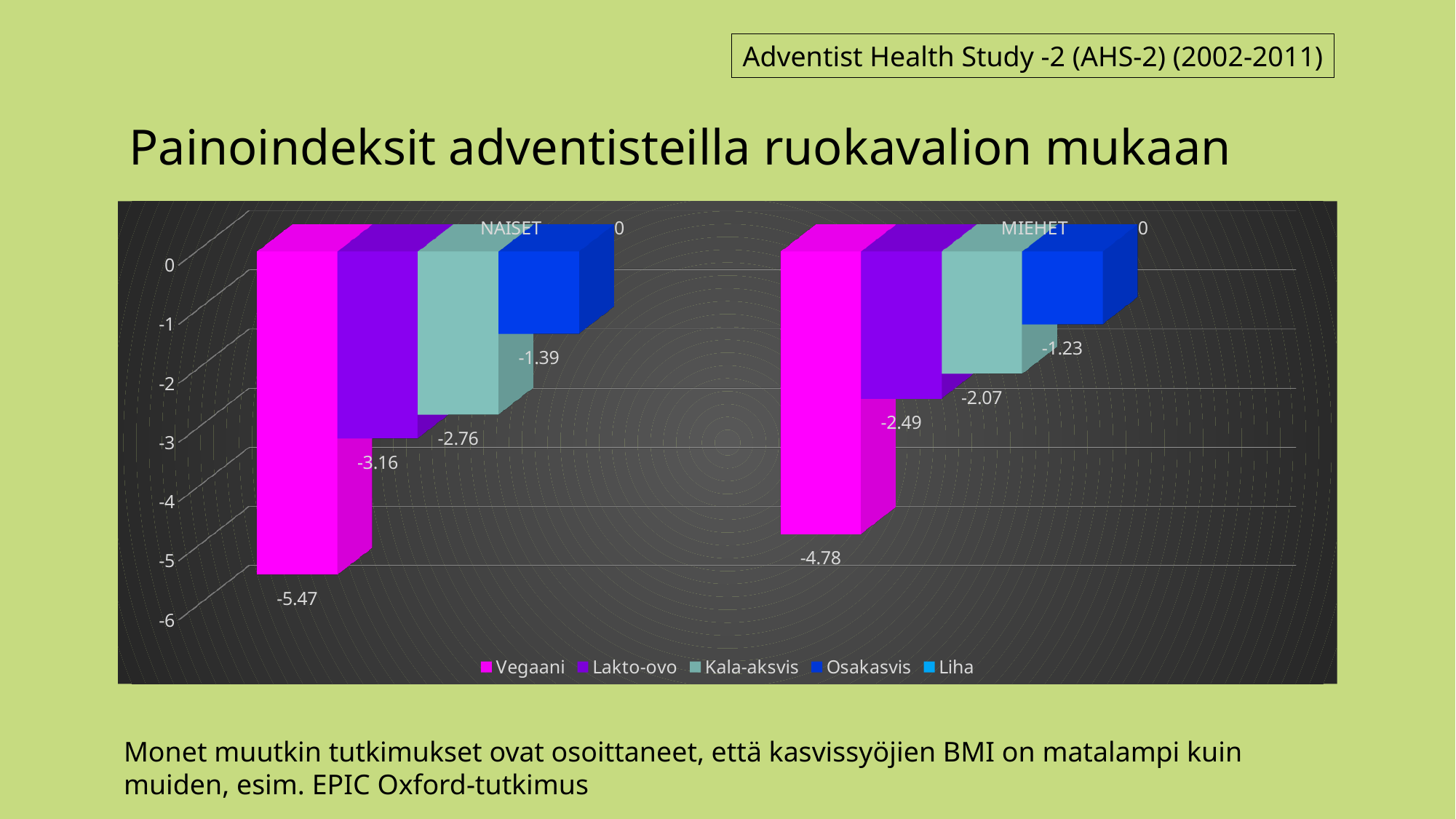
Which series has the highest value in the NAISET group? Liha What is the value for Liha in the NAISET group? 0 What is the difference between the Vegaani values for NAISET and MIEHET? 0.69 How many series does the legend list? 5 Which series has the lowest value in the MIEHET group? Vegaani Which is larger, the Lakto-ovo value for NAISET or for MIEHET? MIEHET What is the value for Lakto-ovo in the MIEHET group? -2.49 What is the value for Vegaani in the NAISET group? -5.47 What is the value for Osakasvis in the MIEHET group? -1.23 What is the value for Kala-aksvis in the NAISET group? -2.76 What kind of chart is shown on the slide? Bar chart How many categories are shown on the x axis? 2